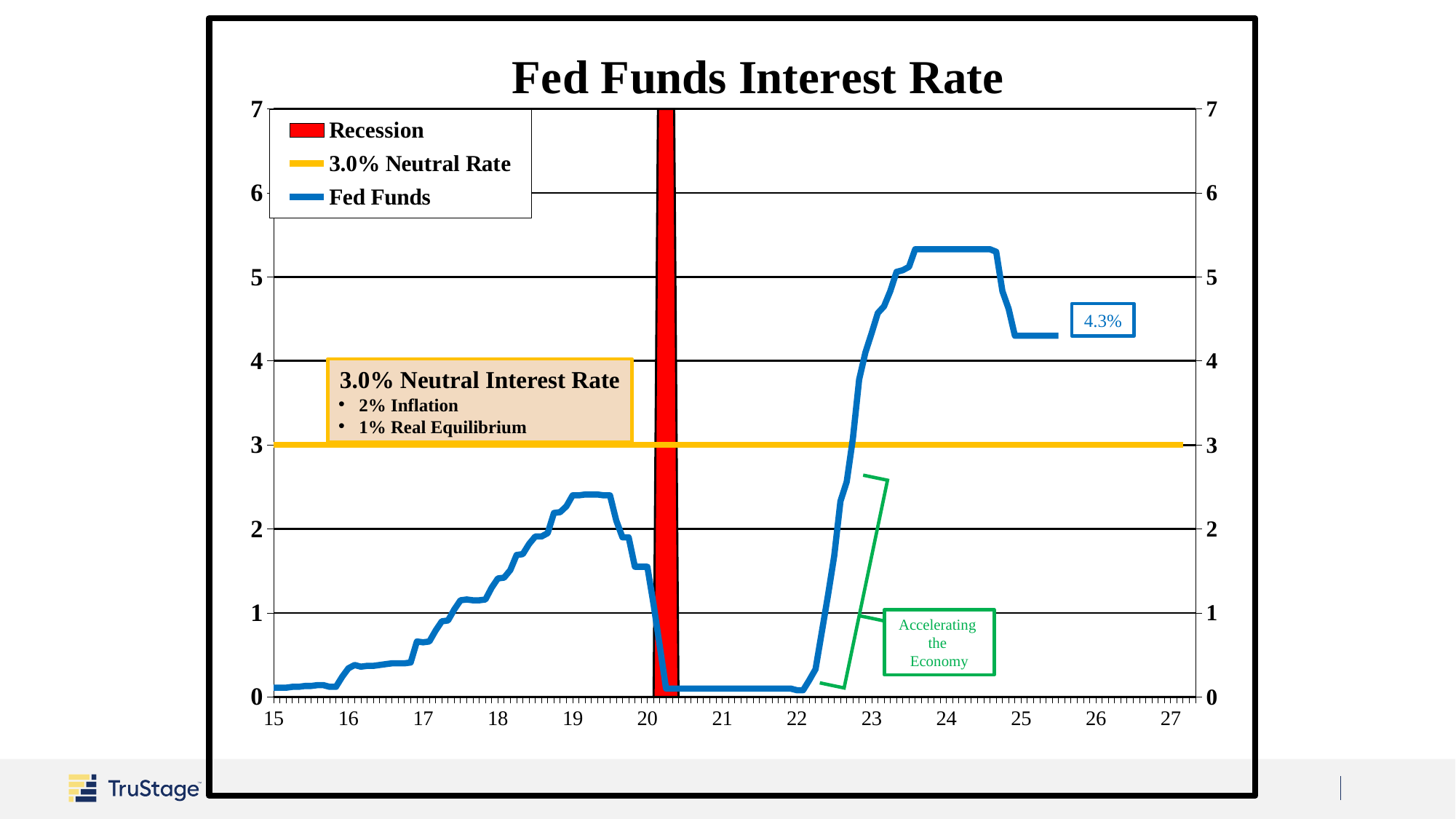
What does the red shaded bar on the chart represent? Recession What value is the neutral interest rate line drawn at? 3.0% Is the Fed Funds rate in 2021 greater or less than 1? less Does the Fed Funds rate rise or fall between 2024 and 2025? fall How many entries does the chart's legend list? 3 Is the Fed Funds rate in 2024 greater or less than 5? greater Which is higher, the Fed Funds rate in 2024 or in 2019? 2024 Is the peak Fed Funds rate in 2019 greater or less than 3? less What kind of chart is shown on the slide? line chart What is the title of the chart? Fed Funds Interest Rate What is the most recent Fed Funds value labeled on the chart? 4.3% Does the Fed Funds rate rise or fall between 2022 and 2023? rise